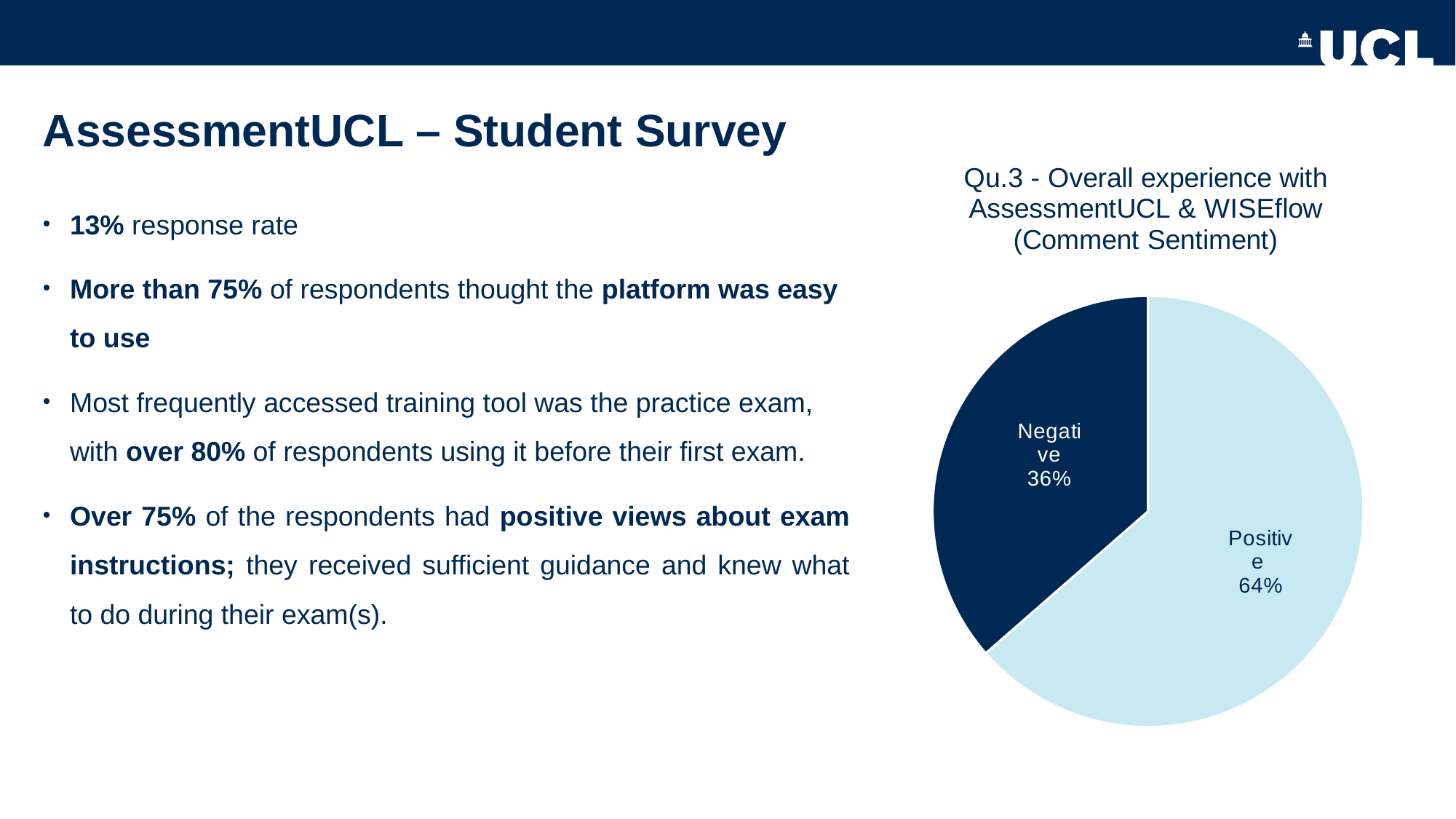
How many slices does the pie chart have? 2 What is the difference in percentage points between the Positive and Negative slices? 28 Which is larger, the Positive slice or the Negative slice? Positive What colour is the Negative slice of the pie chart? Dark blue What is the total of the two slice percentages shown on the pie chart? 100% What share of the pie is labelled Negative? 36% What is the title of the pie chart? Qu.3 - Overall experience with AssessmentUCL & WISEflow (Comment Sentiment) What share of the pie is labelled Positive? 64% What kind of chart is shown on the slide? Pie chart Which slice of the pie chart is the smallest? Negative Which slice of the pie chart is the largest? Positive